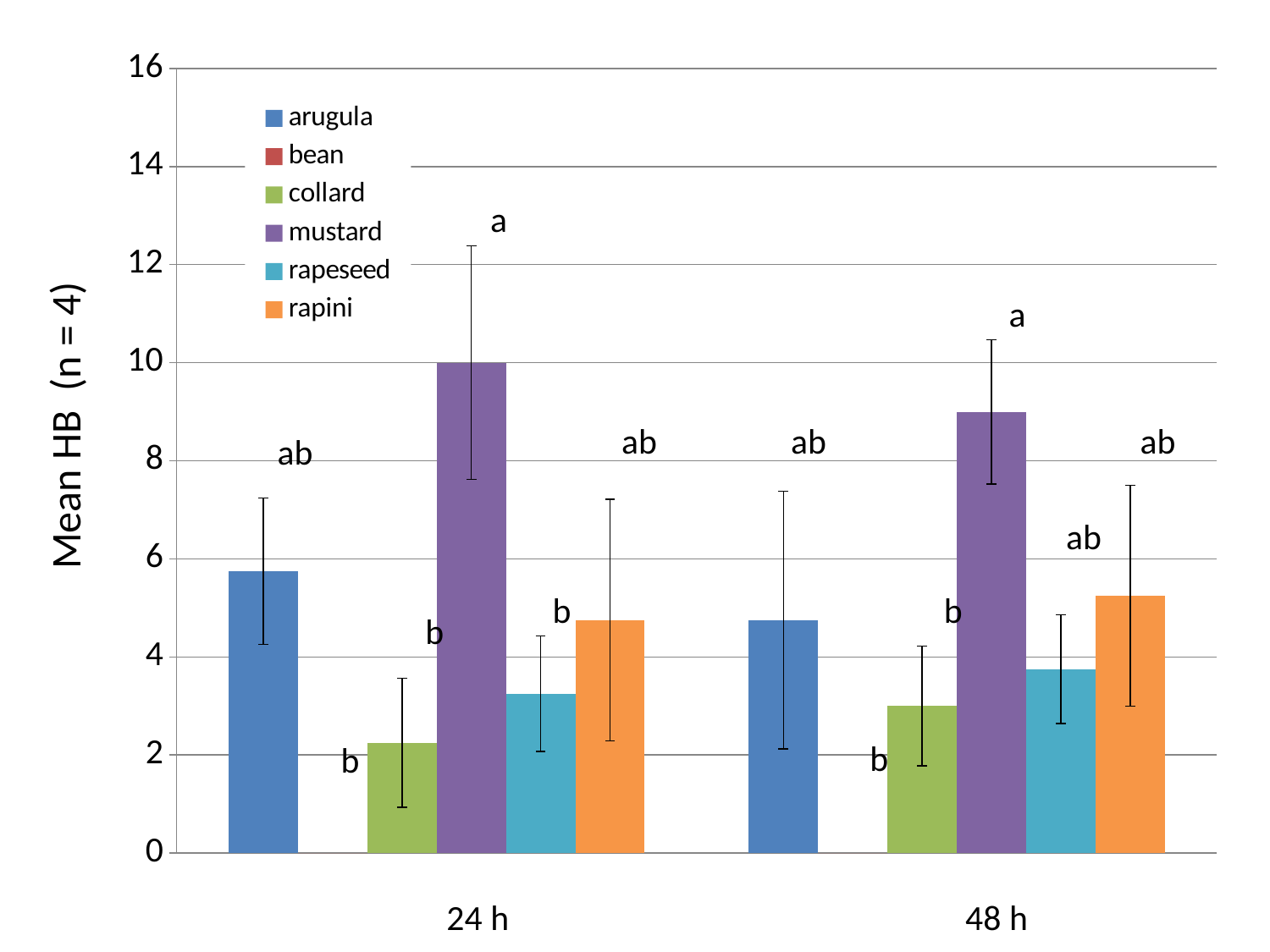
What is the label of the y axis? Mean HB (n = 4) Which is larger, the value for rapeseed at 48 h or the value for rapini at 48 h? rapini at 48 h Which series has the lowest visible bar at 24 h (excluding bean)? collard Which is larger, the value for arugula at 24 h or the value for arugula at 48 h? arugula at 24 h What kind of chart is shown on the slide? bar chart How many series does the legend list? 6 How many time-point categories are shown on the x axis? 2 Which series has the highest value at 48 h? mustard Is the value for mustard at 48 h greater or less than 8? greater Is the value for collard at 24 h greater or less than 4? less Which series has the highest value at 24 h? mustard Is the value for arugula at 24 h greater or less than 4? greater